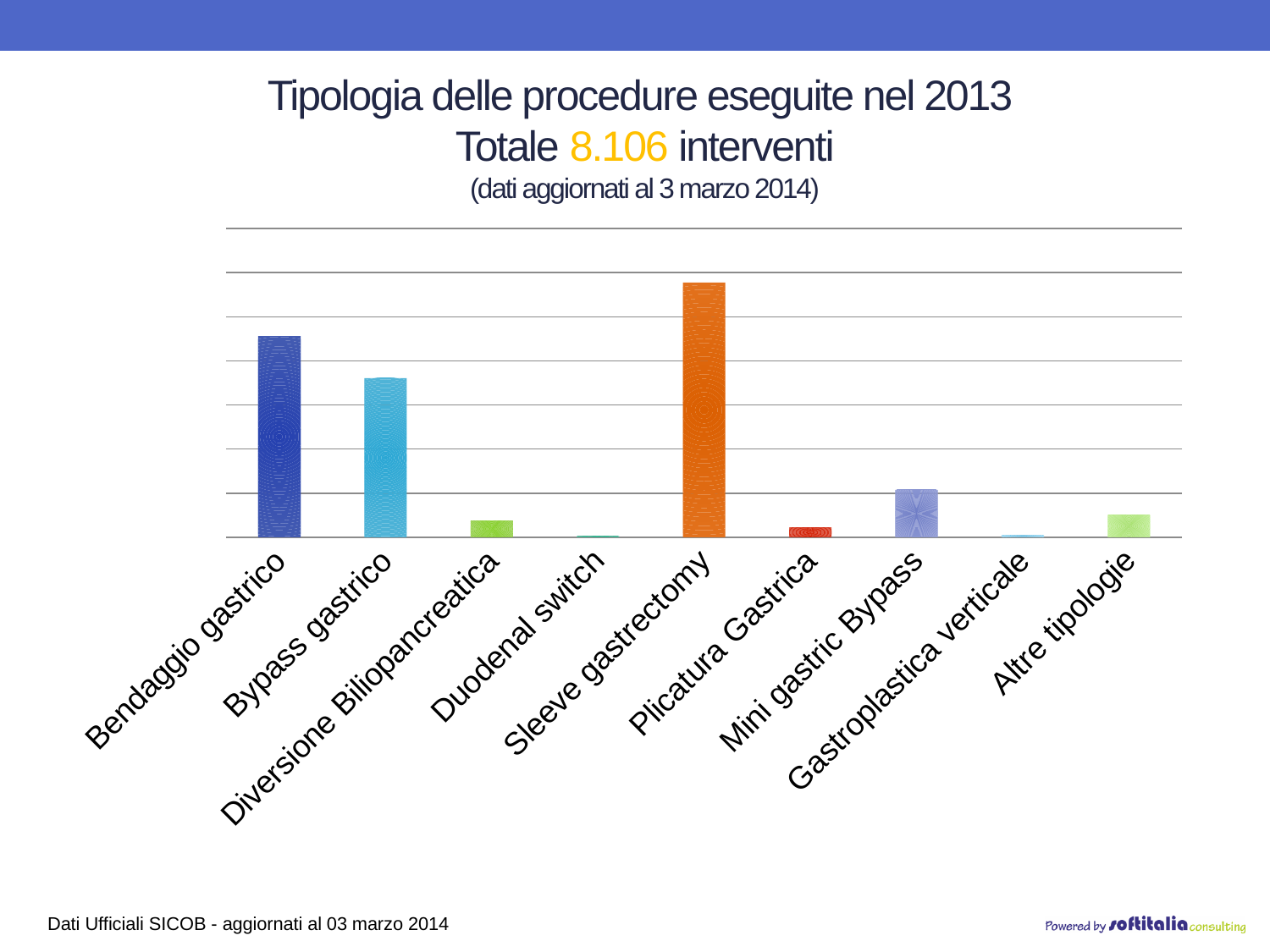
Which bar is taller, Bendaggio gastrico or Bypass gastrico? Bendaggio gastrico According to the slide title, what is the total number of interventi in 2013? 8.106 How many procedure categories are shown on the x axis of the chart? 9 Which bar is taller, Sleeve gastrectomy or Bendaggio gastrico? Sleeve gastrectomy Which bar is taller, Bypass gastrico or Mini gastric Bypass? Bypass gastrico What is the title of the chart on the slide? Tipologia delle procedure eseguite nel 2013 Which procedure has the second highest bar in the chart? Bendaggio gastrico Which procedure has the highest bar in the chart? Sleeve gastrectomy What kind of chart is shown on the slide? bar chart